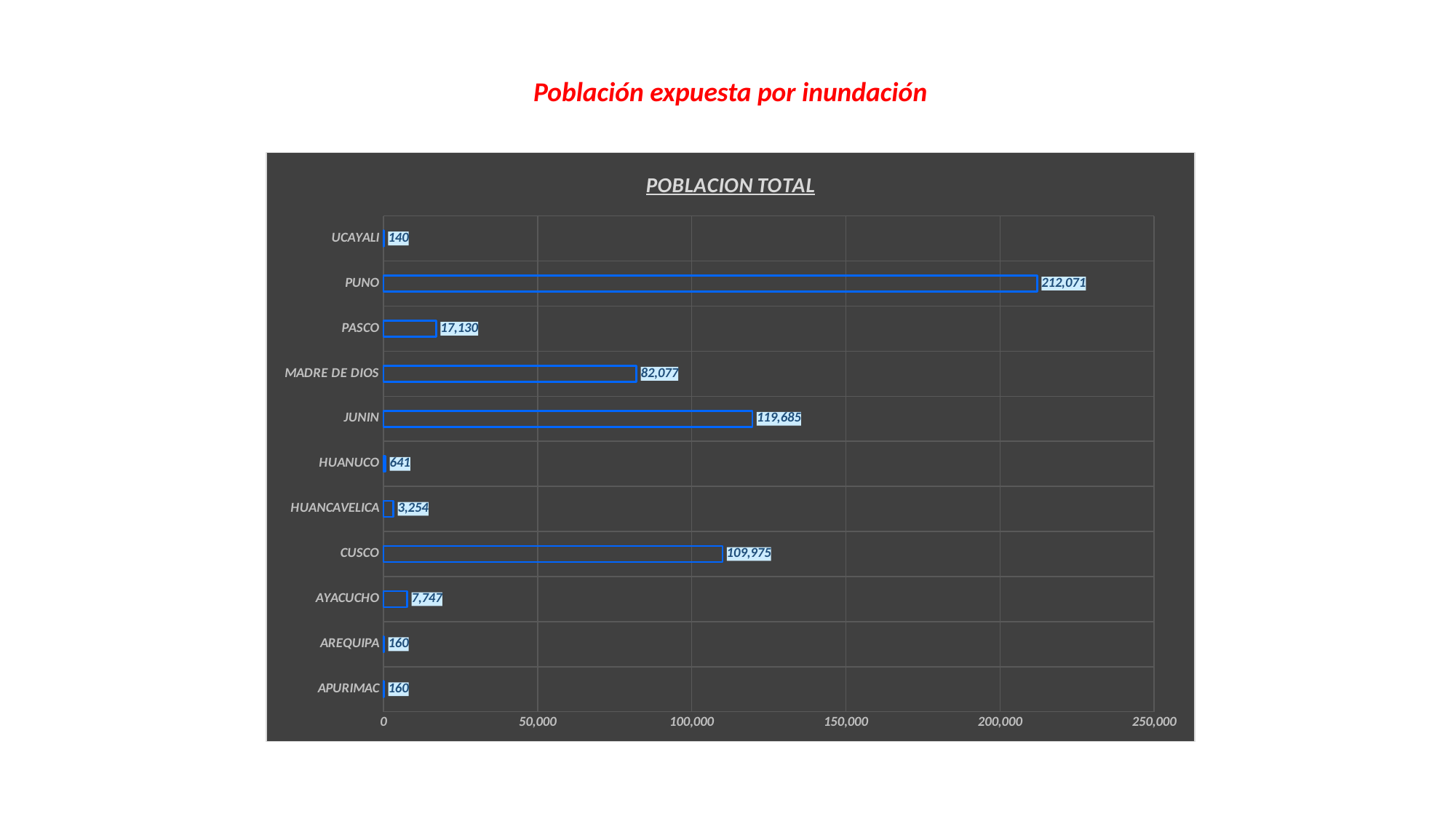
Which category has the highest value? PUNO What is the difference between the values for PUNO and JUNIN? 92,386 Is the value for CUSCO greater or less than 100,000? greater What kind of chart is shown? bar chart What is the title of the chart? POBLACION TOTAL What is the value for HUANCAVELICA? 3,254 What is the value for MADRE DE DIOS? 82,077 What is the value for PUNO? 212,071 Which is larger, the value for PASCO or the value for AYACUCHO? PASCO What is the difference between the values for JUNIN and CUSCO? 9,710 Which category has the lowest value? UCAYALI How many categories are shown in the chart? 11